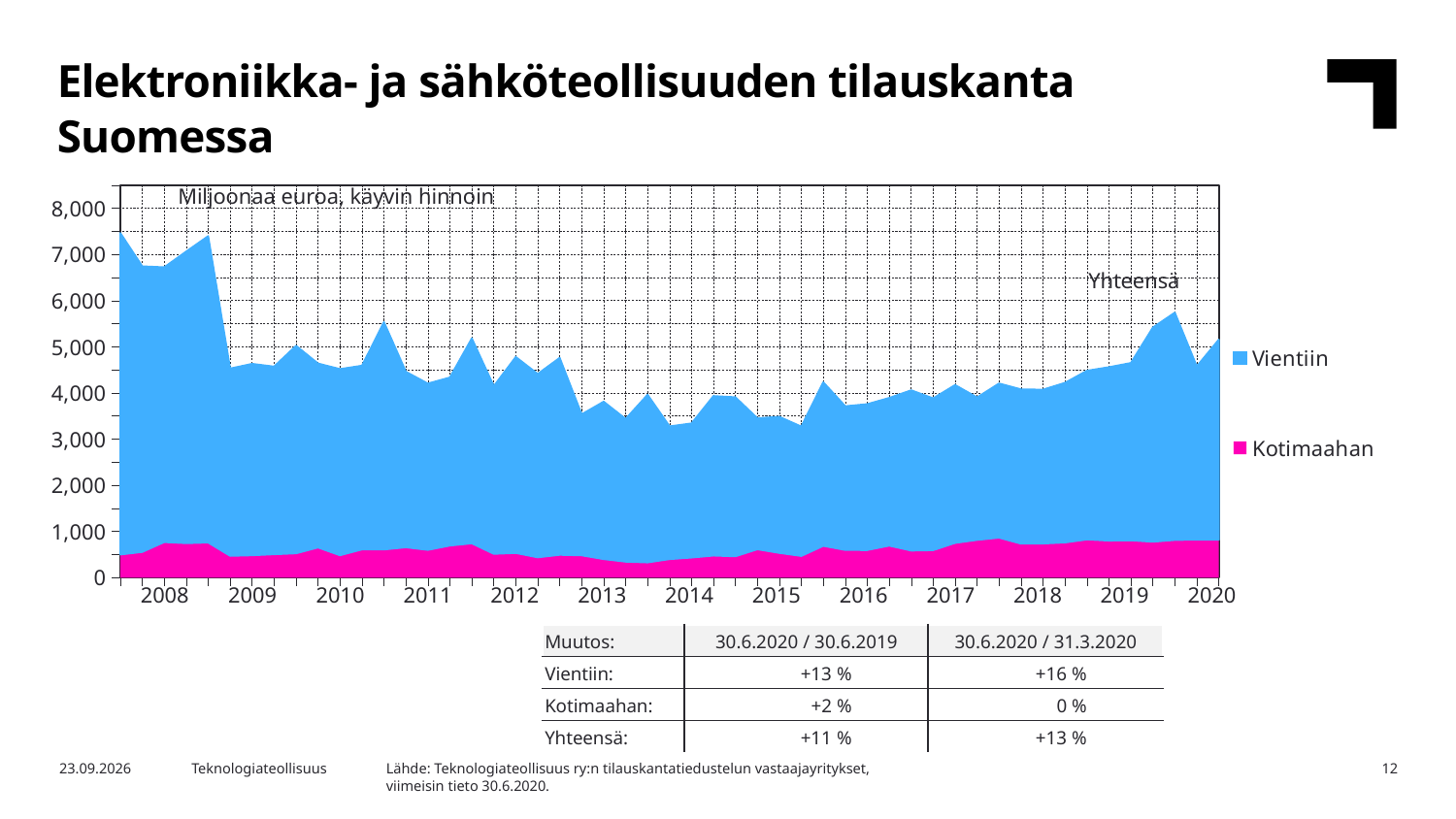
How many series does the chart legend list? 2 Is the Kotimaahan value in 2014 greater or less than 1,000? less What unit label is printed at the top of the chart area? Miljoonaa euroa, käyvin hinnoin Which two series are listed in the chart legend? Vientiin and Kotimaahan Is the total (Yhteensä) value at the 2014 tick greater or less than 4,000? less Does the total (Yhteensä) value rise or fall from 2008 to 2009? fall Is the total (Yhteensä) value at the 2016 tick greater or less than 5,000? less Which series is larger throughout the chart, Vientiin or Kotimaahan? Vientiin What kind of chart is shown on the slide? Area chart How many year labels are shown on the x axis? 13 According to the table below the chart, what is the change for Vientiin between 30.6.2019 and 30.6.2020? +13 %